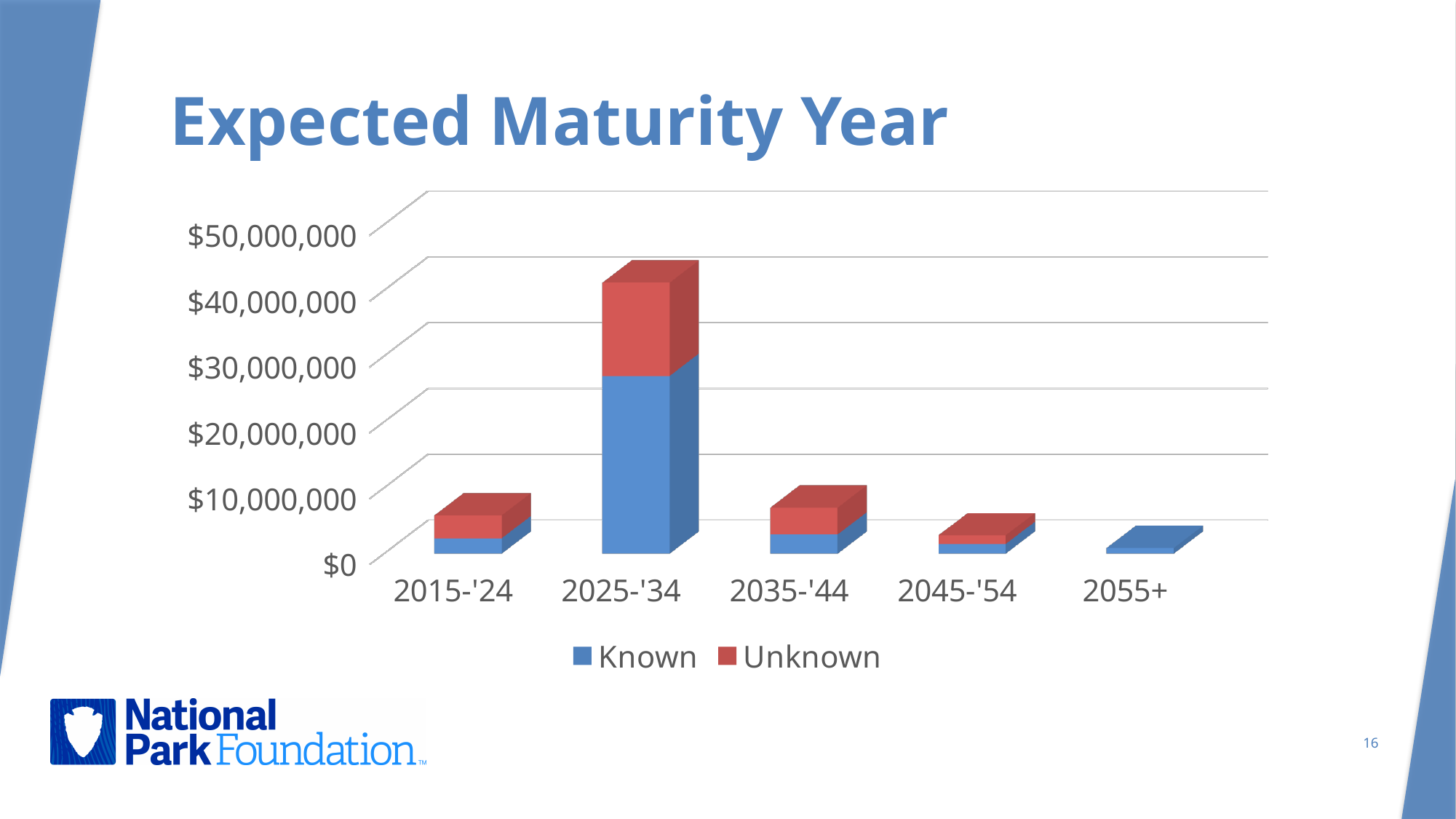
Is the total stacked value for 2025-'34 greater or less than $30,000,000? greater Which colour represents the Unknown series in the legend? Red Which maturity-year category has the shortest stacked bar? 2055+ Is the Known value for 2025-'34 greater or less than $20,000,000? greater What is the title of the chart? Expected Maturity Year What kind of chart is shown on the slide? Bar chart Is the total stacked value for 2015-'24 greater or less than $10,000,000? less Which has the larger total stacked bar, 2035-'44 or 2045-'54? 2035-'44 How many series does the legend list? 2 Which maturity-year category has the tallest stacked bar? 2025-'34 How many maturity-year categories are shown on the x axis? 5